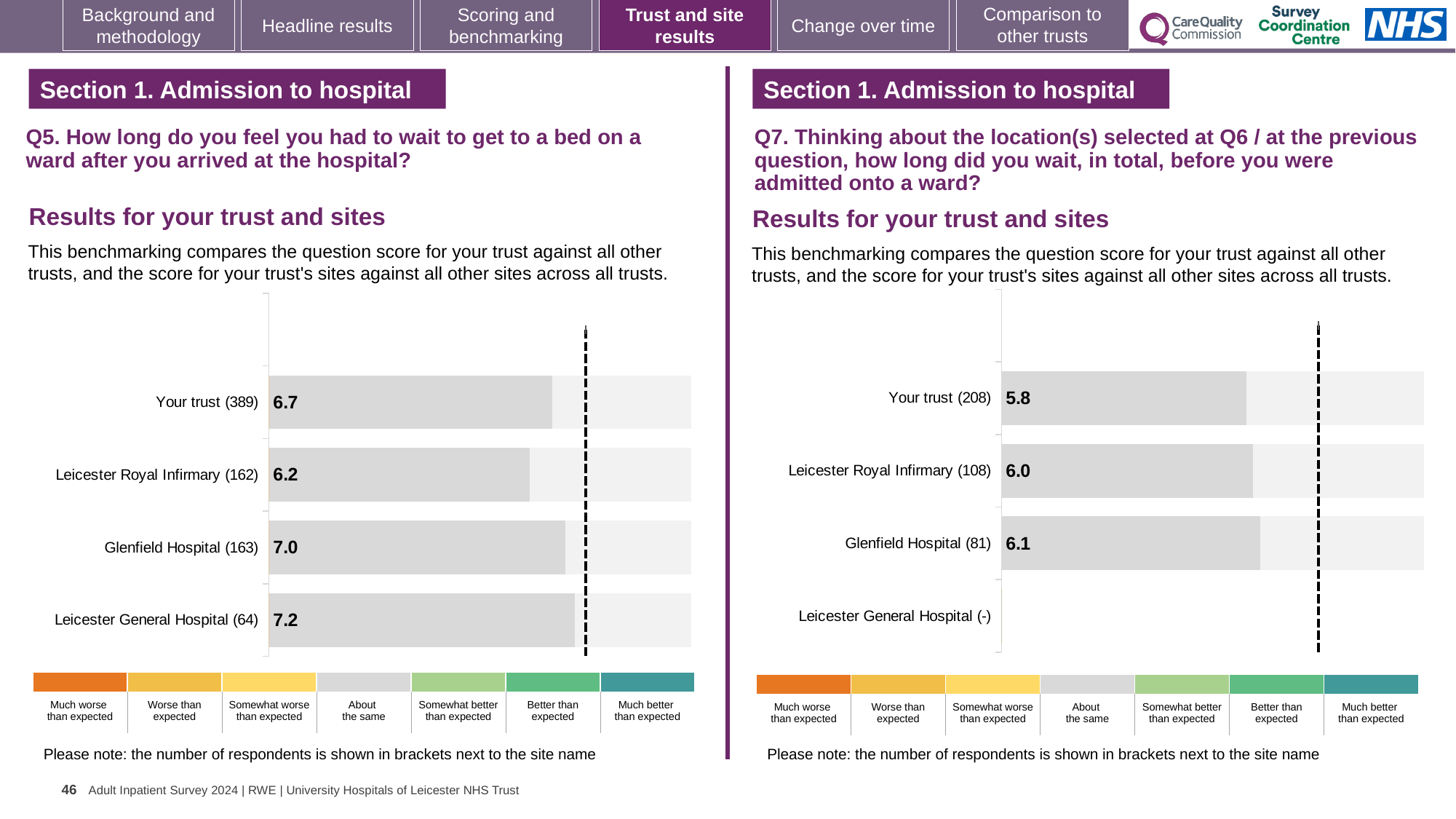
On the Q5 chart (left), which site or trust row has the lowest score? Leicester Royal Infirmary On the Q5 chart (left), how many respondents are shown in brackets for Glenfield Hospital? 163 On the Q5 chart (left), what is the difference between the scores for Leicester General Hospital and Leicester Royal Infirmary? 1.0 On the Q5 chart (left), what is the score for Your trust? 6.7 On the Q5 chart (left), what is the score for Leicester Royal Infirmary? 6.2 On the Q7 chart (right), what is the difference between the scores for Glenfield Hospital and Your trust? 0.3 On the Q7 chart (right), how many rows (trust and sites) are listed? 4 What kind of chart is used on the Q5 chart (left)? Bar chart On the Q5 chart (left), which site or trust row has the highest score? Leicester General Hospital On the Q7 chart (right), what is the score for Glenfield Hospital? 6.1 On the Q7 chart (right), which is larger, the score for Leicester Royal Infirmary or the score for Your trust? Leicester Royal Infirmary On the Q7 chart (right), what is the score for Your trust? 5.8